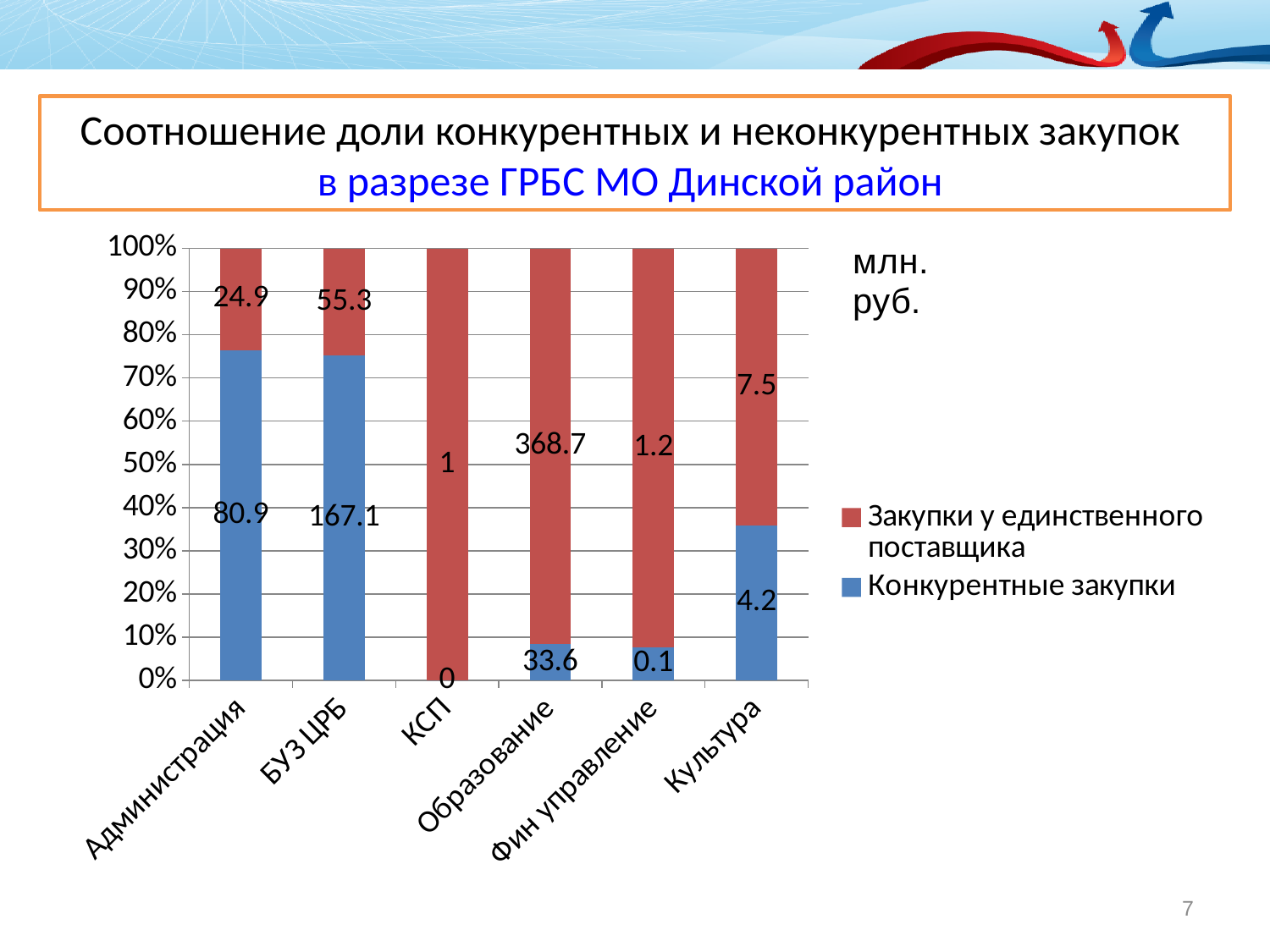
What is the value of Закупки у единственного поставщика for Образование? 368.7 Which category has the highest value for Закупки у единственного поставщика? Образование What is the value of Конкурентные закупки for Администрация? 80.9 What is the total of the two series for Администрация? 105.8 What is the value of Закупки у единственного поставщика for Культура? 7.5 What is the difference between Конкурентные закупки and Закупки у единственного поставщика for БУЗ ЦРБ? 111.8 What is the value of Конкурентные закупки for КСП? 0 Which category has the lowest value for Конкурентные закупки? КСП How many series does the legend list? 2 Is the share of Конкурентные закупки in the Администрация bar greater or less than 70%? greater Which is larger for Фин управление: Конкурентные закупки or Закупки у единственного поставщика? Закупки у единственного поставщика How many categories are shown on the x axis? 6